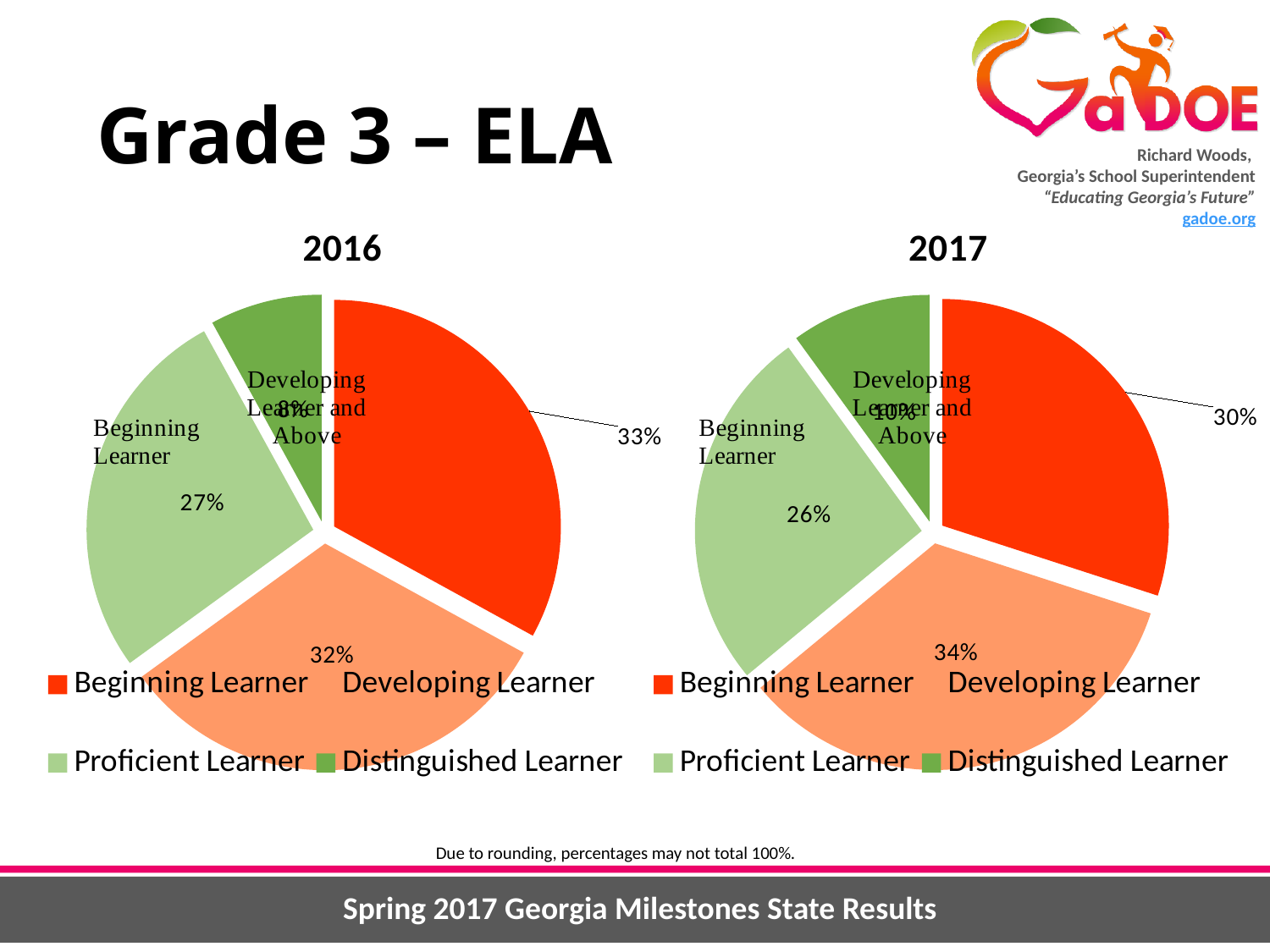
What type of chart is used for the 2016 and 2017 results? Pie chart Which is larger: the Beginning Learner share in the 2016 chart or in the 2017 chart? 2016 How many categories does the legend of the 2017 pie chart list? 4 In the 2016 pie chart, what percentage is shown for Developing Learner? 32% In the 2017 pie chart, what percentage is shown for Developing Learner? 34% In the 2017 pie chart, what is the difference in percentage points between Developing Learner and Proficient Learner? 8 percentage points In the 2017 pie chart, what percentage is shown for Beginning Learner? 30% In the 2016 pie chart, which category has the smallest slice? Distinguished Learner In the 2016 pie chart, what percentage is shown for Beginning Learner? 33% In the 2017 pie chart, what percentage is shown for Proficient Learner? 26% In the 2017 pie chart, which category has the largest slice? Developing Learner In the 2016 pie chart, what percentage is shown for Proficient Learner? 27%